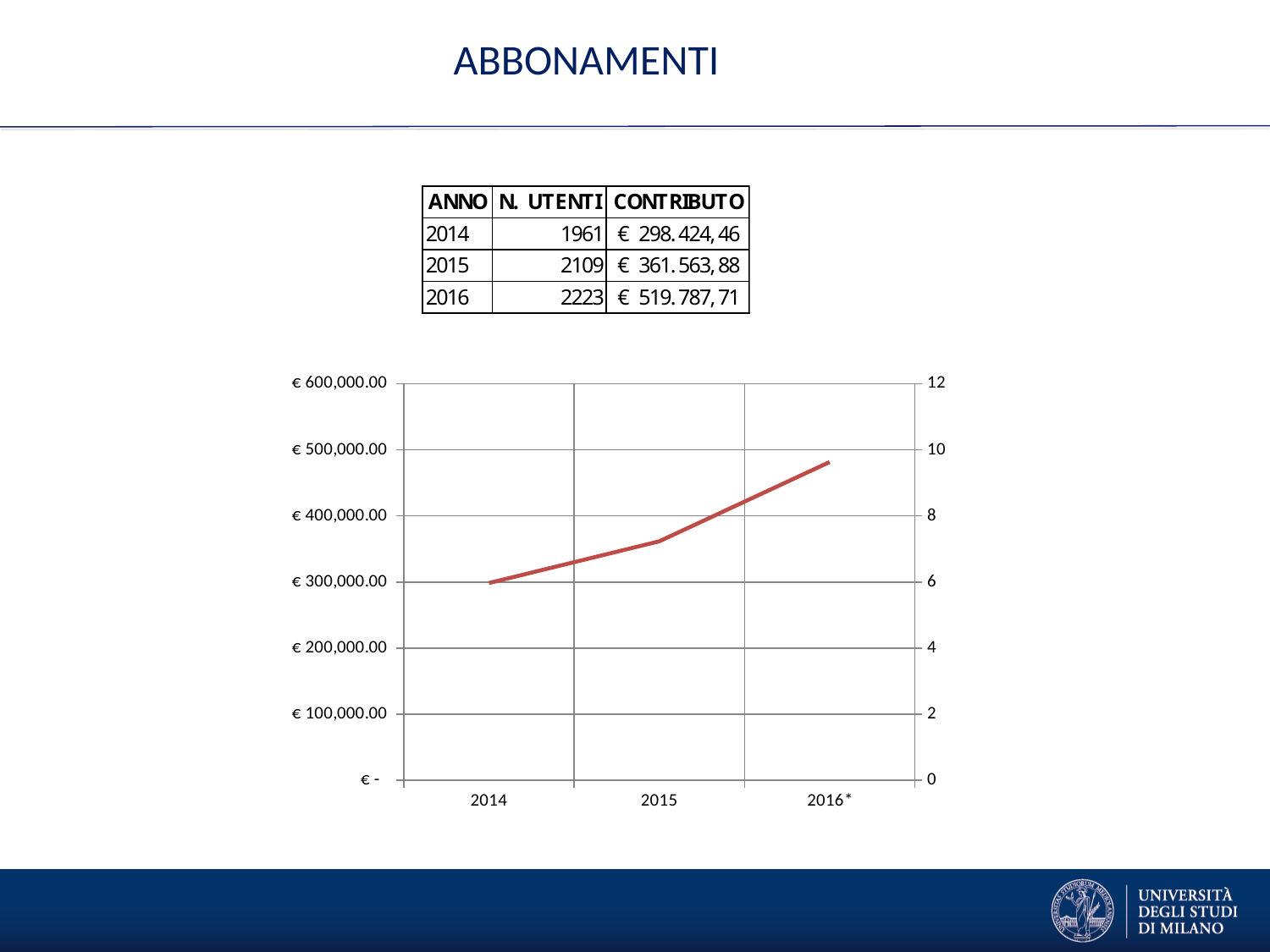
How many data points are plotted on the line chart? 3 Is the value for 2014 on the line chart greater or less than € 200,000.00? greater Does the line rise or fall from 2014 to 2016*? rises Is the value for 2016* on the line chart greater or less than € 400,000.00? greater What kind of chart is shown on the slide? line chart What is the highest tick label on the left vertical axis of the chart? € 600,000.00 What is the highest tick label on the right vertical axis of the chart? 12 Is the value for 2014 on the line chart greater or less than € 400,000.00? less Which is larger on the line chart, the value for 2015 or the value for 2014? 2015 Which year has the highest value on the line chart? 2016* Which year has the lowest value on the line chart? 2014